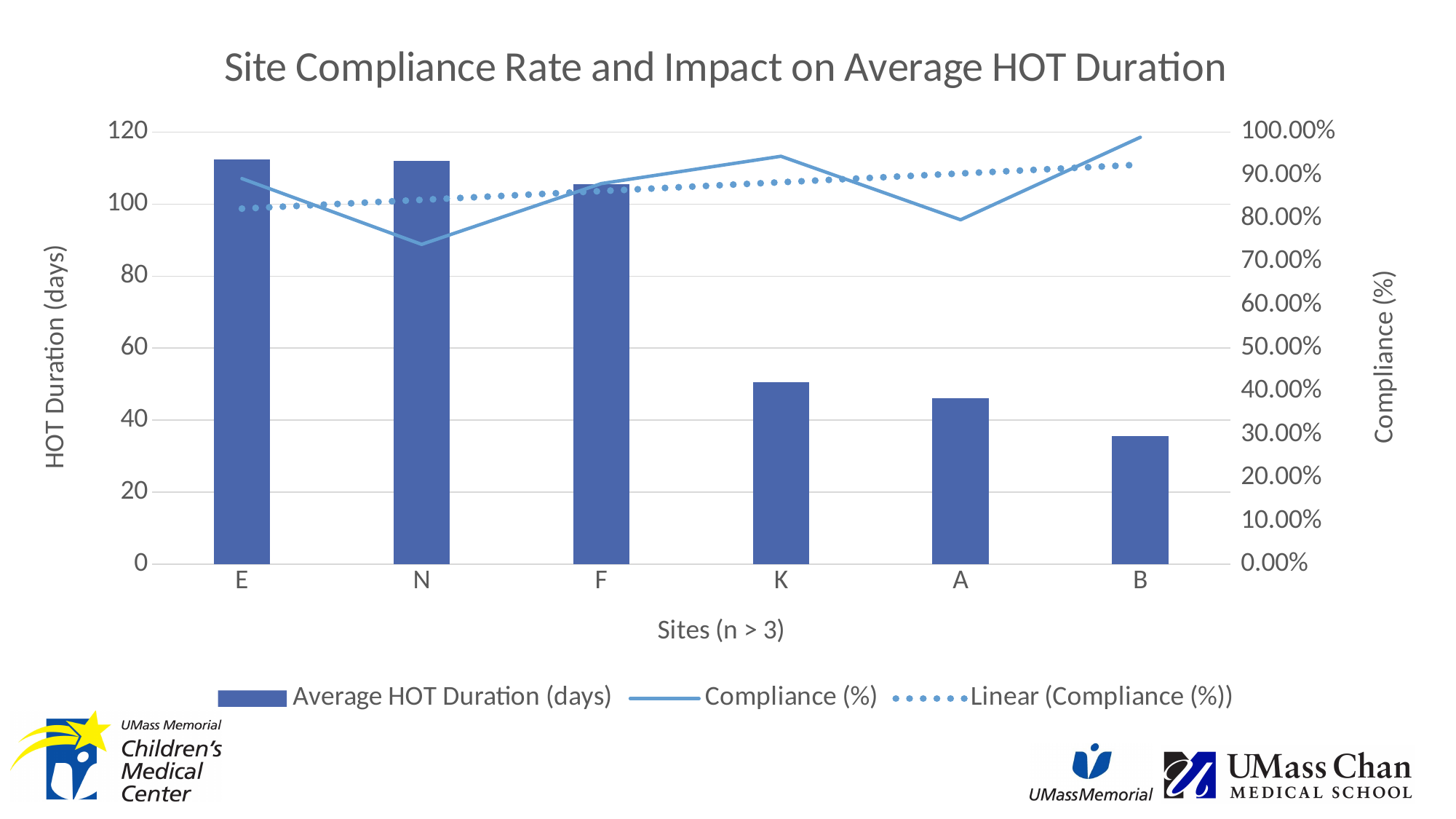
Is the Compliance (%) for site N greater or less than 80.00%? less Is the Average HOT Duration for site E greater or less than 100 days? greater What kind of chart is this? Combined bar and line chart How many series does the legend list? 3 Which site has the lowest Average HOT Duration (days)? B What is the title of the chart? Site Compliance Rate and Impact on Average HOT Duration How many sites are shown on the x axis? 6 Is the Average HOT Duration for site K greater or less than 60 days? less Which site has the lowest Compliance (%)? N Which site has the highest Compliance (%)? B Which site has a larger Average HOT Duration, F or A? F Do the Average HOT Duration bars generally rise or fall from site E to site B? fall